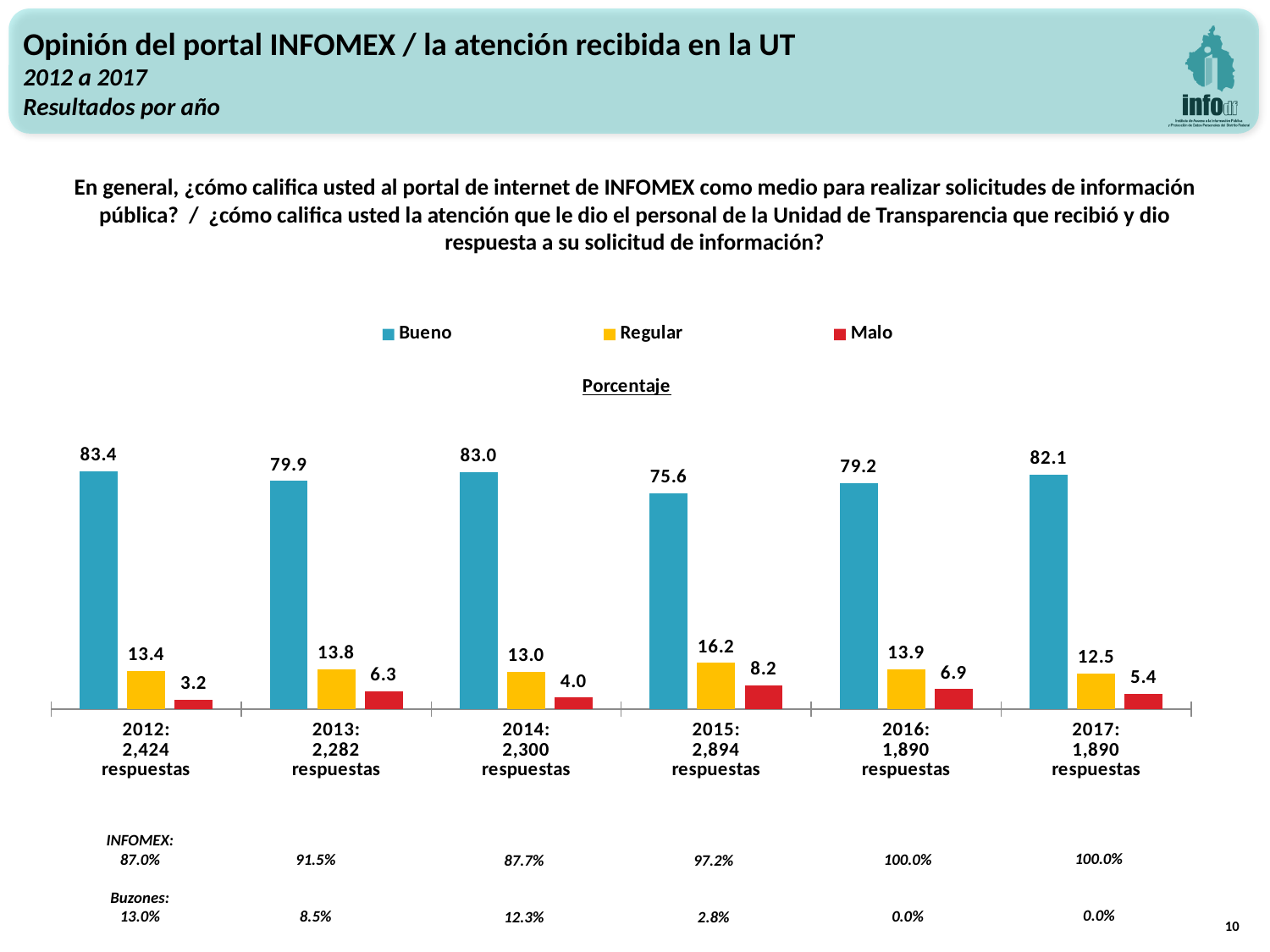
What is the difference between the Bueno values for 2012 and 2015? 7.8 In which year is the Malo value lowest? 2012 In which year is the Bueno value lowest? 2015 Which is larger, the Regular value in 2015 or the Regular value in 2016? 2015 How many years are shown on the x axis? 6 What is the value for Bueno in 2012? 83.4 What kind of chart is shown on the slide? Bar chart What is the value for Malo in 2015? 8.2 Which colour represents the Malo series in the legend? Red In which year is the Bueno value highest? 2012 What is the value for Regular in 2017? 12.5 How many series does the legend list? 3